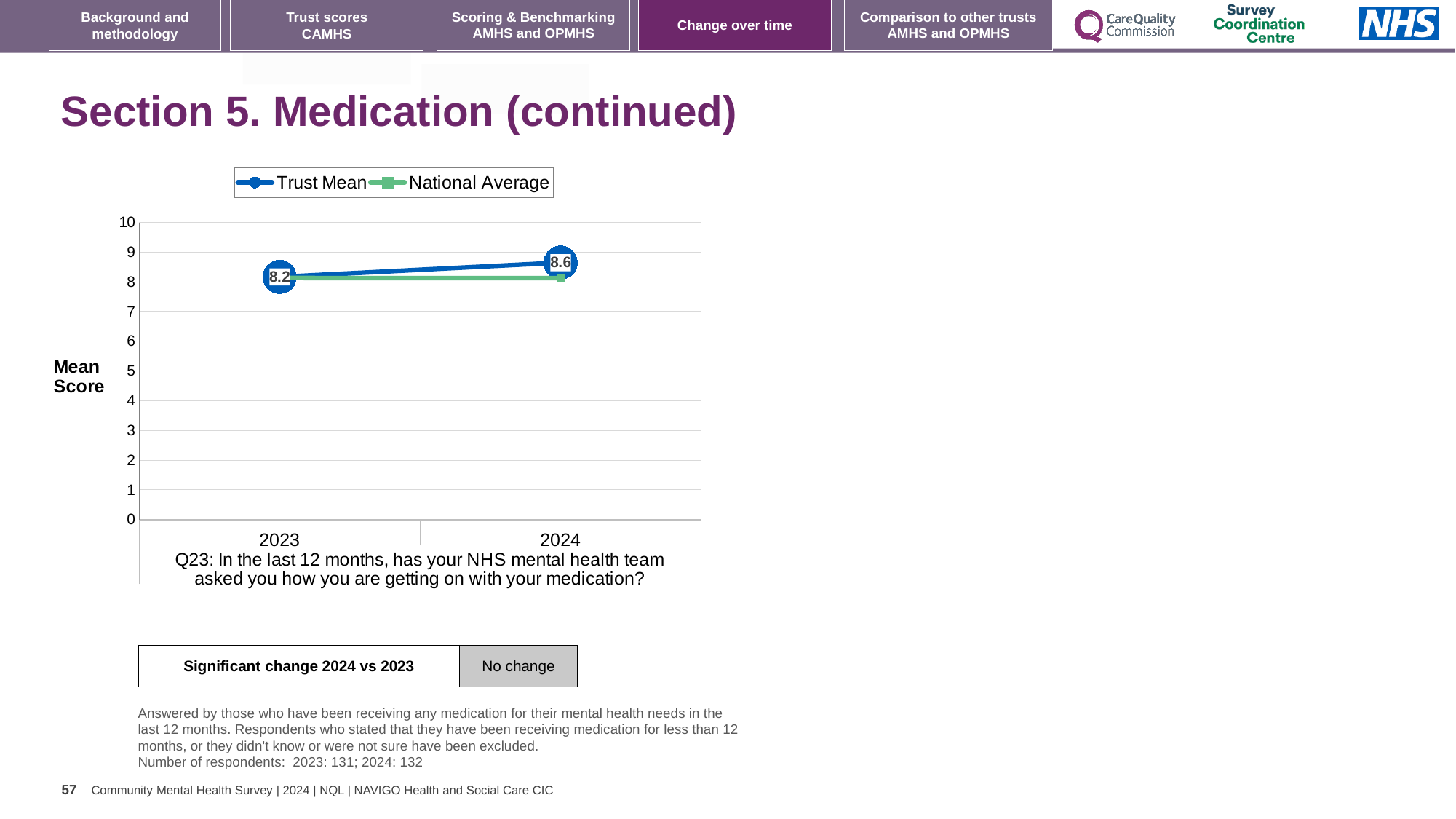
Which year has the higher Trust Mean, 2023 or 2024? 2024 Is the National Average value for 2023 greater or less than 7? greater How many series does the legend list? 2 Is the National Average value for 2024 greater or less than 9? less In 2024, which is higher, the Trust Mean or the National Average? Trust Mean What is the label on the y axis of the chart? Mean Score By how much did the Trust Mean change from 2023 to 2024? 0.4 What is the Trust Mean value for 2023? 8.2 What is the Trust Mean value for 2024? 8.6 Does the Trust Mean rise or fall from 2023 to 2024? rise How many years are plotted on the x axis? 2 What kind of chart is shown on the slide? line chart